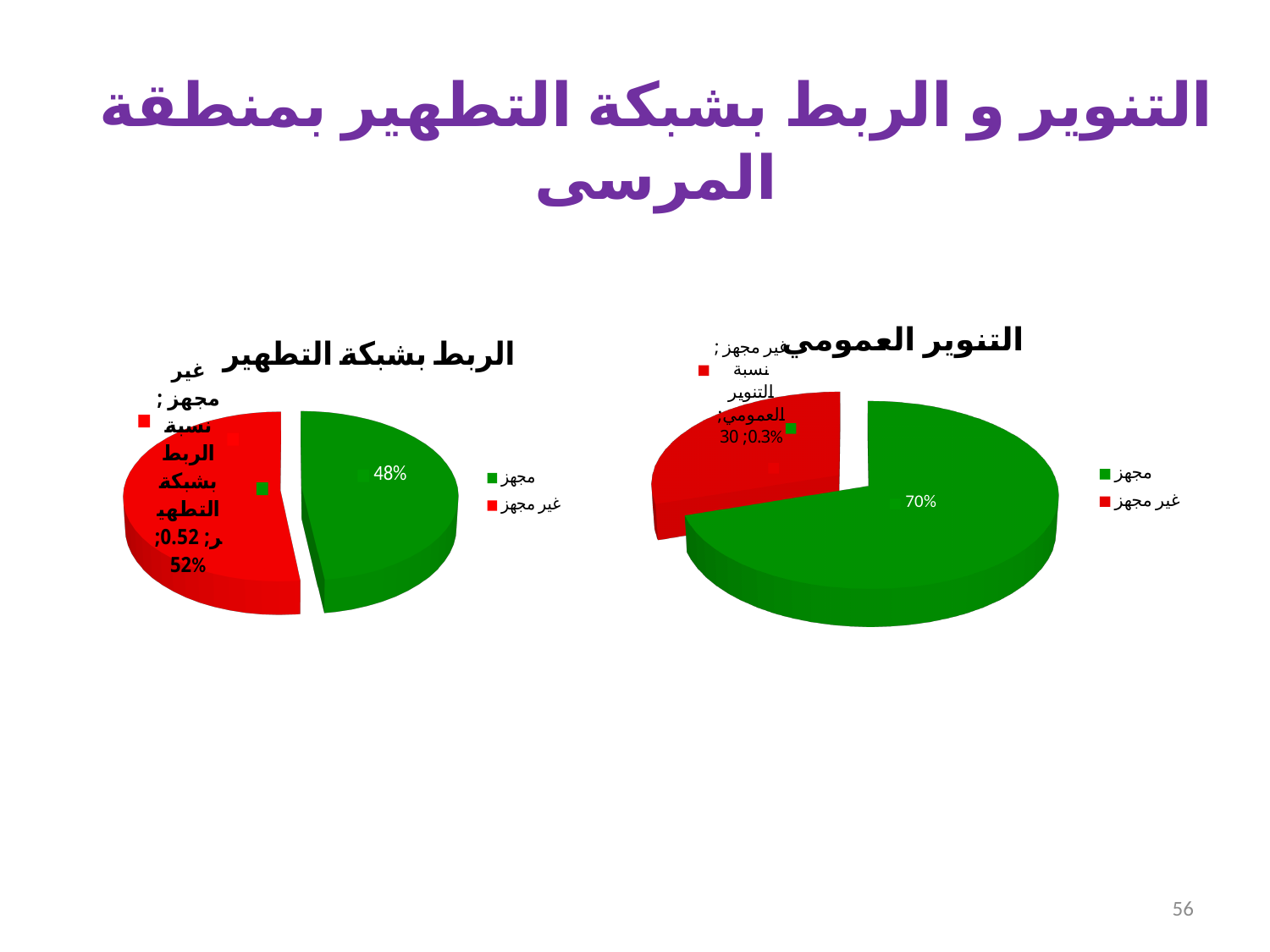
In the "التنوير العمومي" chart, what is the difference between the "مجهز" and "غير مجهز" shares? 40% What type of chart is the "التنوير العمومي" chart? pie chart In the "التنوير العمومي" chart, which category has the largest slice? مجهز In the "التنوير العمومي" chart, what share does "غير مجهز" have? 30% How many entries does the legend of the "التنوير العمومي" chart list? 2 In the "الربط بشبكة التطهير" chart, which is larger: "مجهز" or "غير مجهز"? غير مجهز In the "التنوير العمومي" chart, what colour is the "غير مجهز" slice? red In the "الربط بشبكة التطهير" chart, what share does "غير مجهز" have? 52% In the "الربط بشبكة التطهير" chart, which category has the smallest slice? مجهز In the "التنوير العمومي" chart, what share does "مجهز" have? 70% How many slices does the "الربط بشبكة التطهير" chart have? 2